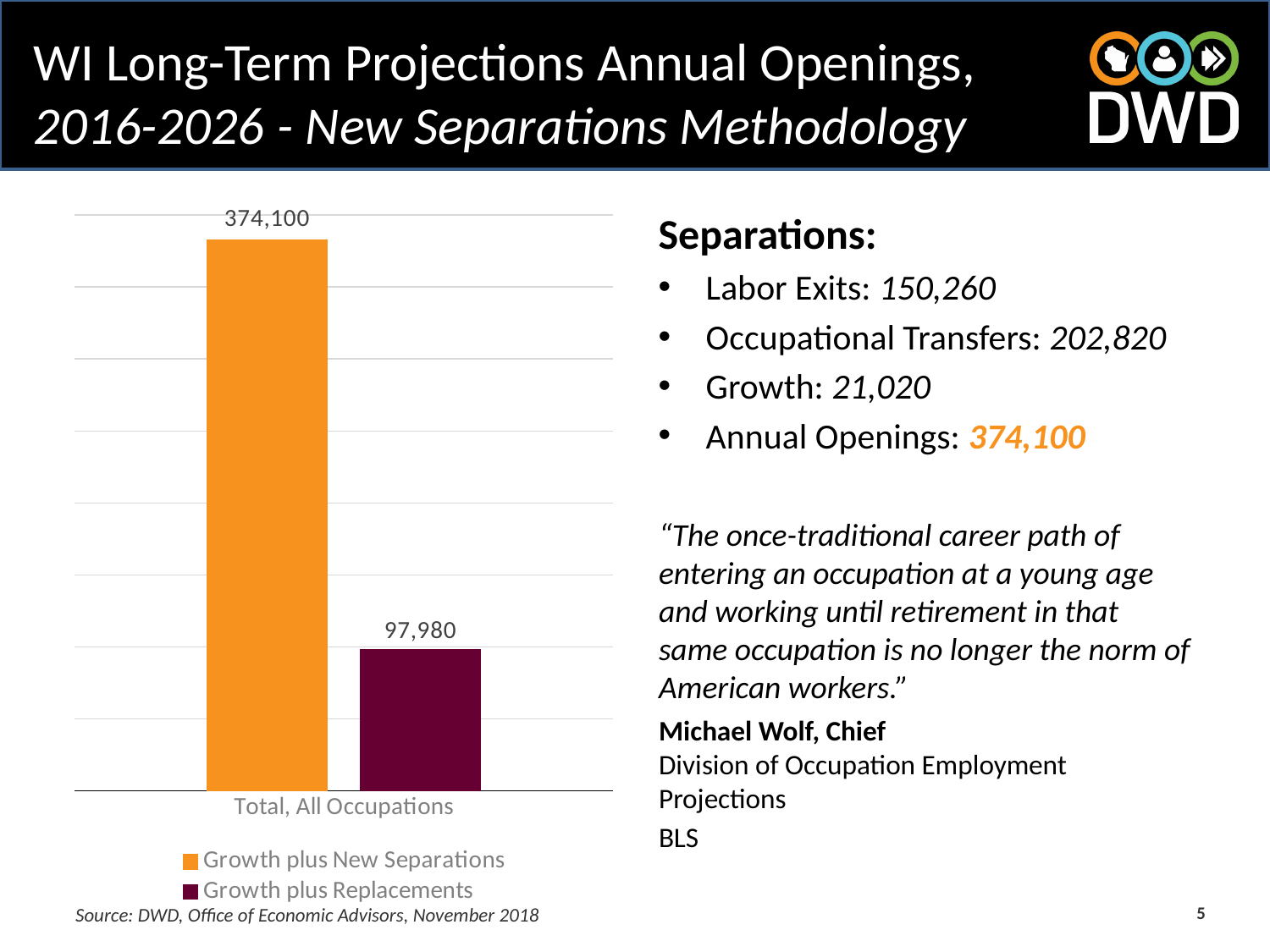
What kind of chart is shown on the slide? Bar chart How many categories are shown on the x axis? 1 Which series has the lowest value on the chart? Growth plus Replacements What is the value for Growth plus New Separations for Total, All Occupations? 374,100 Which series has the higher value: Growth plus New Separations or Growth plus Replacements? Growth plus New Separations How many series does the legend list? 2 What is the value for Growth plus Replacements for Total, All Occupations? 97,980 What colour is the bar for Growth plus New Separations? Orange What is the difference between the Growth plus New Separations value and the Growth plus Replacements value? 276,120 What is the category label on the x axis? Total, All Occupations